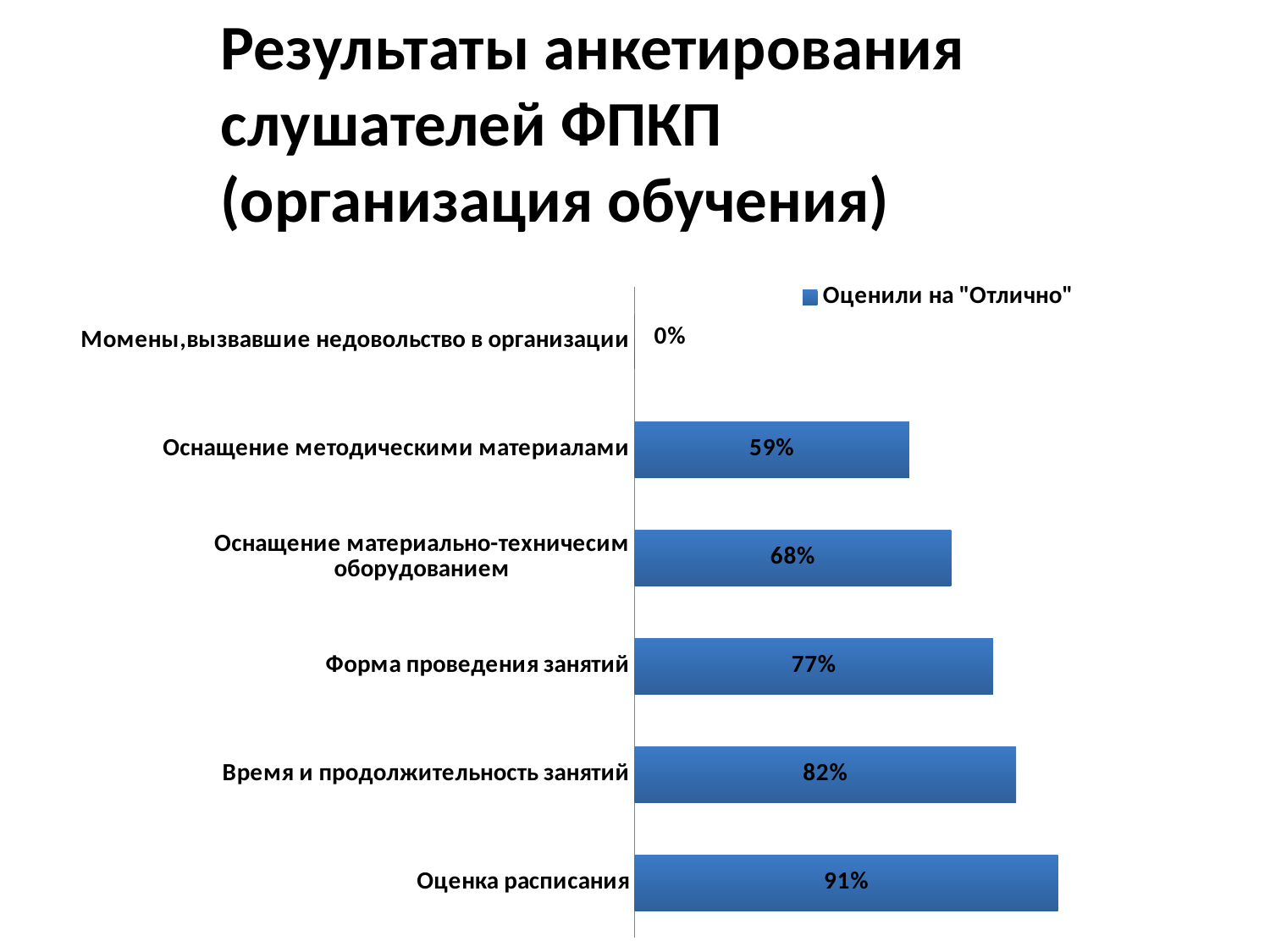
How many categories are shown in the chart? 6 What is the value for "Форма проведения занятий"? 77% What is the value for "Оснащение методическими материалами"? 59% What is the difference between the values for "Оценка расписания" and "Оснащение методическими материалами"? 32% What type of chart is shown on the slide? Bar chart What is the value for "Моменты, вызвавшие недовольство в организации"? 0% What series name does the legend show? Оценили на "Отлично" What is the value for "Время и продолжительность занятий"? 82% What is the value for "Оценка расписания"? 91% Which category has the lowest value? Момены,вызвавшие недовольство в организации Which is larger: the value for "Оснащение материально-техническим оборудованием" or the value for "Форма проведения занятий"? Форма проведения занятий Which category has the highest value? Оценка расписания